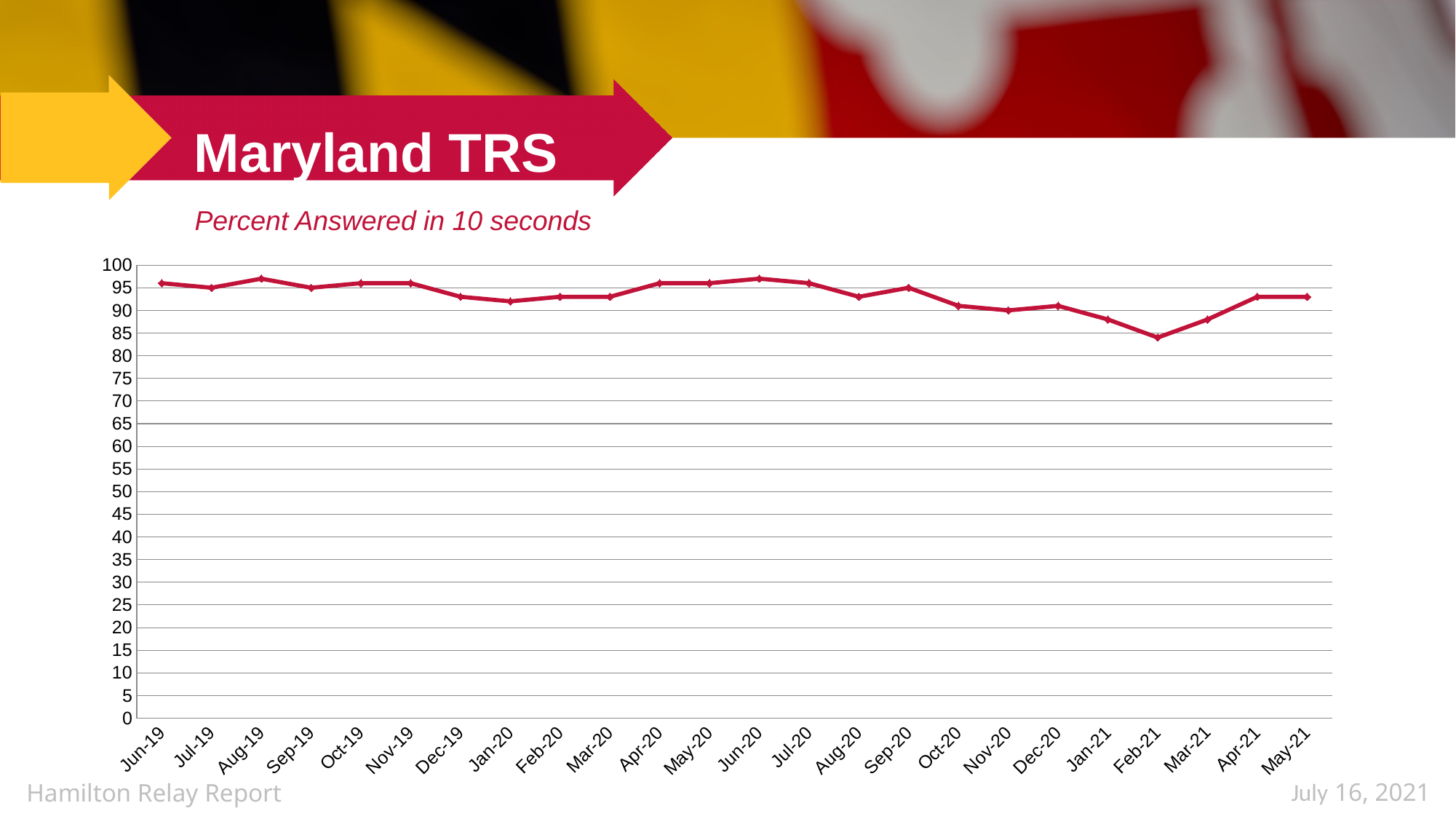
Which is larger, the value for Feb-21 or the value for Apr-21? Apr-21 Is the value for Dec-19 greater or less than 90? greater Do the values rise or fall from Feb-21 to Apr-21? rise What kind of chart is shown on the slide? line chart Is the value for Feb-21 greater or less than 90? less What is the title of the chart? Percent Answered in 10 seconds Which is larger, the value for Jun-20 or the value for Jan-21? Jun-20 Which month has the lowest value? Feb-21 How many months are plotted along the x axis? 24 Is the value for Jun-20 greater or less than 95? greater What colour is the plotted line? red